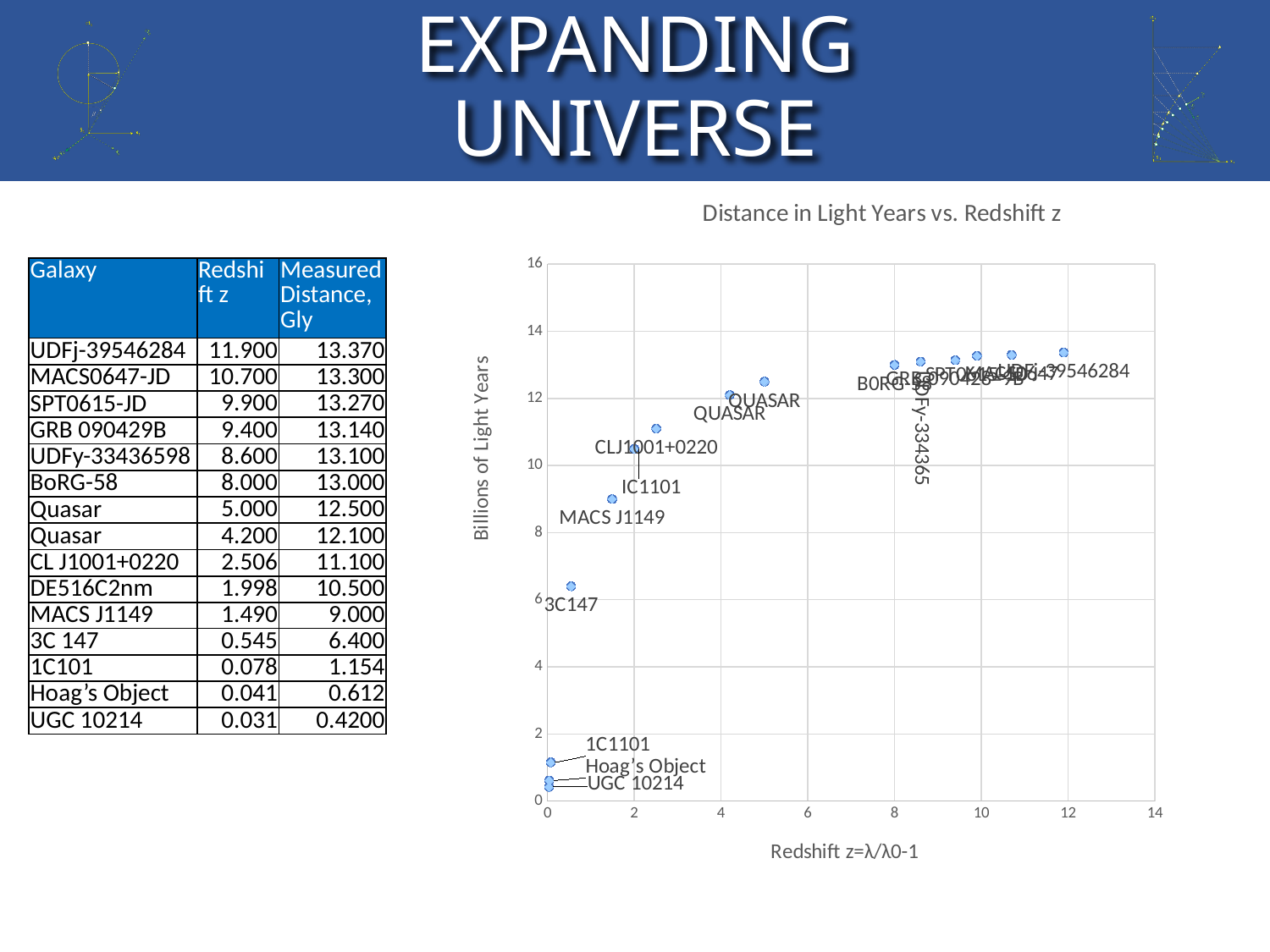
Is the value for IC1101 greater or less than 12 billion light years? less What kind of chart is shown on the slide? Scatter chart Is the value for 3C147 greater or less than 8 billion light years? less Which has the larger distance value, 3C147 or MACS J1149? MACS J1149 Is the value for Hoag's Object greater or less than 2 billion light years? less Which has the larger distance value, CLJ1001+0220 or IC1101? CLJ1001+0220 What is the title of the chart? Distance in Light Years vs. Redshift z Do the distance values generally rise or fall as redshift increases along the x axis? Rise What is the label on the vertical axis of the chart? Billions of Light Years